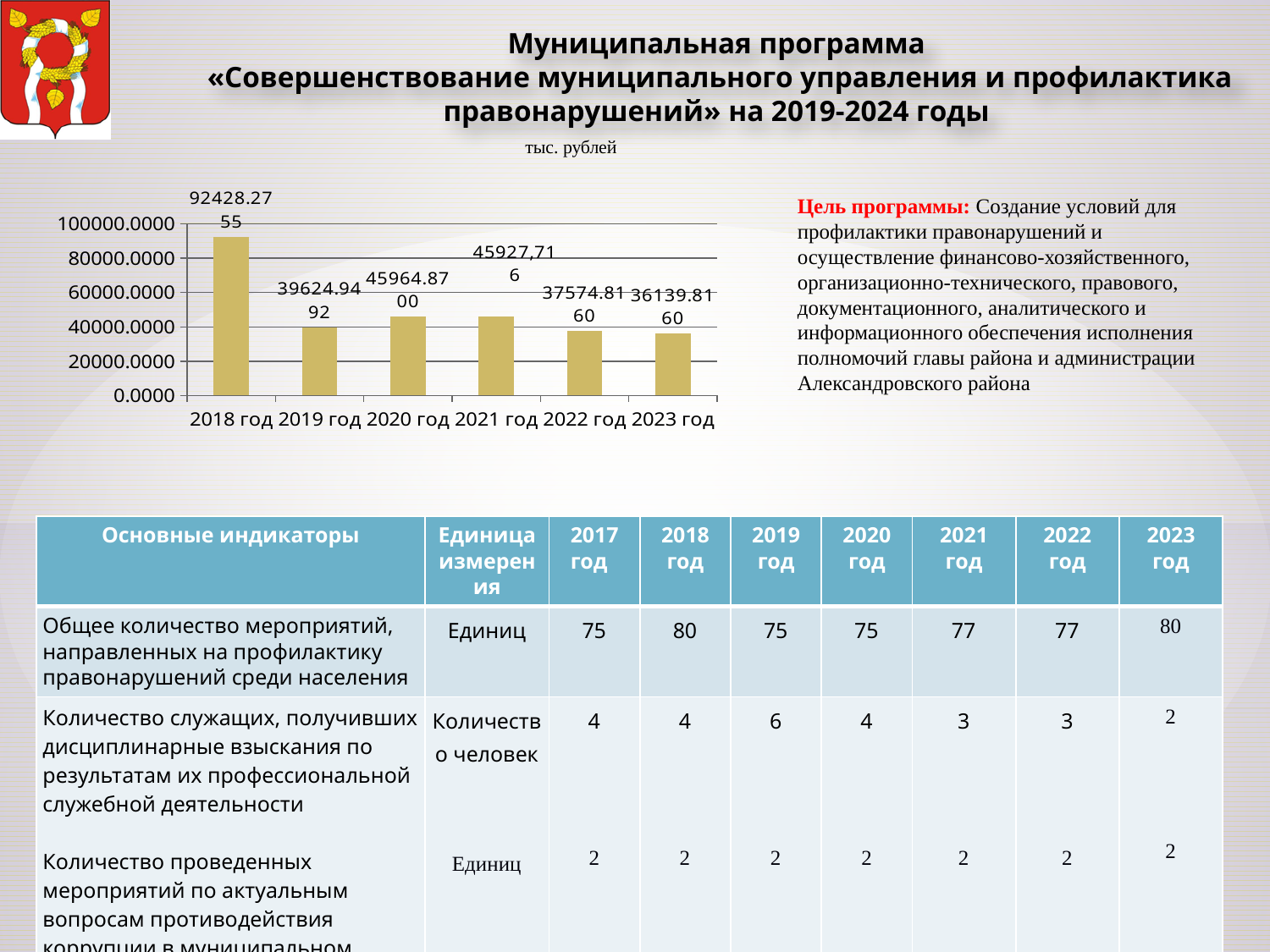
What is the value shown for 2018 год in the bar chart? 92428.2755 What is the value shown for 2023 год in the bar chart? 36139.8160 What unit of measurement is indicated above the bar chart? тыс. рублей How many years (categories) are plotted in the bar chart? 6 What is the value shown for 2019 год in the bar chart? 39624.9492 Which is larger in the bar chart: the value for 2019 год or the value for 2020 год? 2020 год Is the value for 2022 год greater or less than 40000? less Which year has the highest value in the bar chart? 2018 год Is the value for 2018 год greater or less than 80000? greater What is the difference between the values for 2022 год and 2023 год in the bar chart? 1435 Which year has the lowest value in the bar chart? 2023 год What type of chart is shown on the slide? bar chart